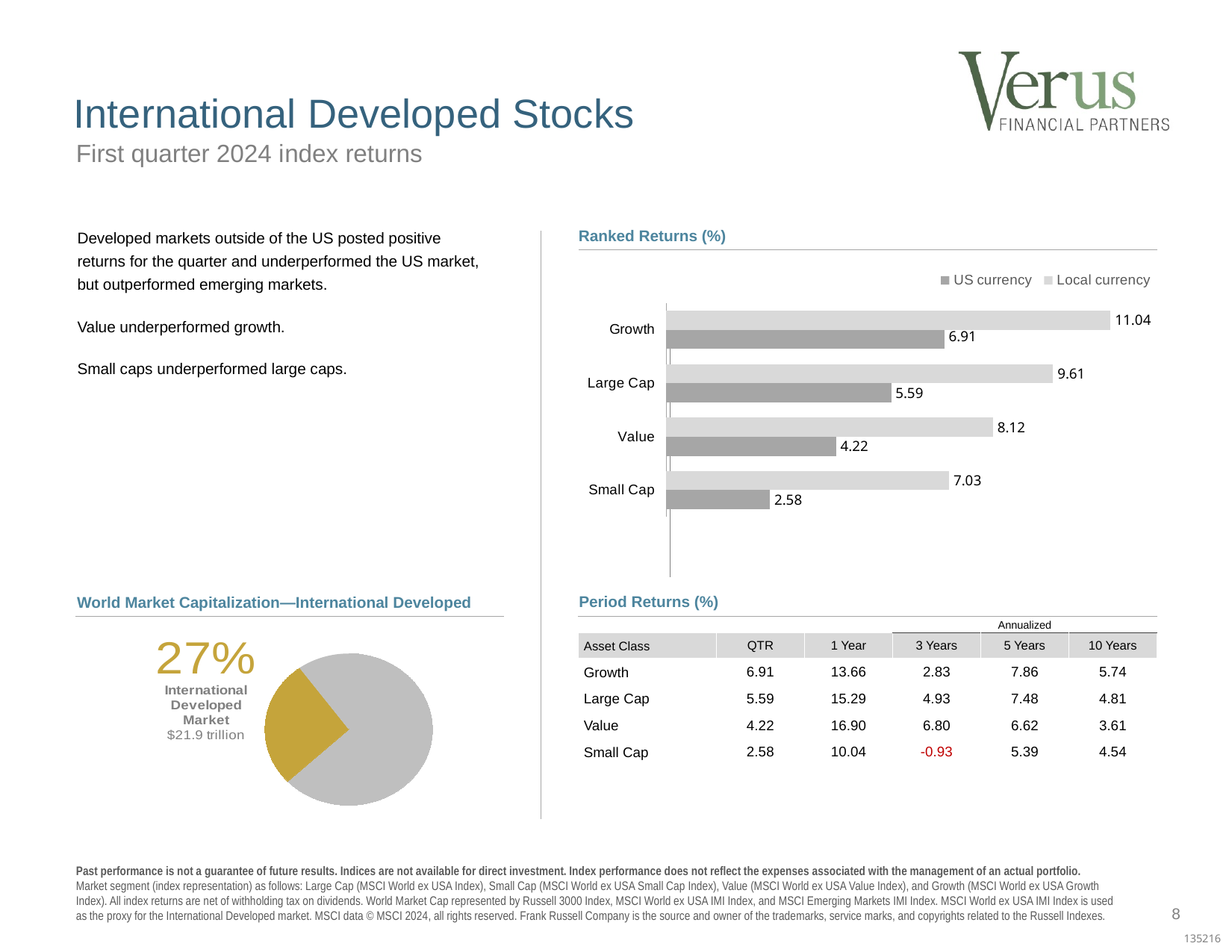
How many series does the legend of the Ranked Returns (%) chart list? 2 In the Ranked Returns (%) chart, which category has the highest Local currency return? Growth In the Ranked Returns (%) chart, what is the US currency return for Growth? 6.91 In the Ranked Returns (%) chart, which is larger: the US currency return for Large Cap or the US currency return for Value? Large Cap In the Ranked Returns (%) chart, which category has the lowest US currency return? Small Cap In the World Market Capitalization—International Developed chart, what share of world market capitalization does the International Developed Market represent? 27% What kind of chart is the Ranked Returns (%) chart? Bar chart In the Ranked Returns (%) chart, what is the Local currency return for Large Cap? 9.61 How many categories are shown in the Ranked Returns (%) chart? 4 What kind of chart is the World Market Capitalization—International Developed chart? Pie chart In the Ranked Returns (%) chart, what is the difference between the Local currency and US currency returns for Value? 3.90 In the Ranked Returns (%) chart, what is the Local currency return for Small Cap? 7.03